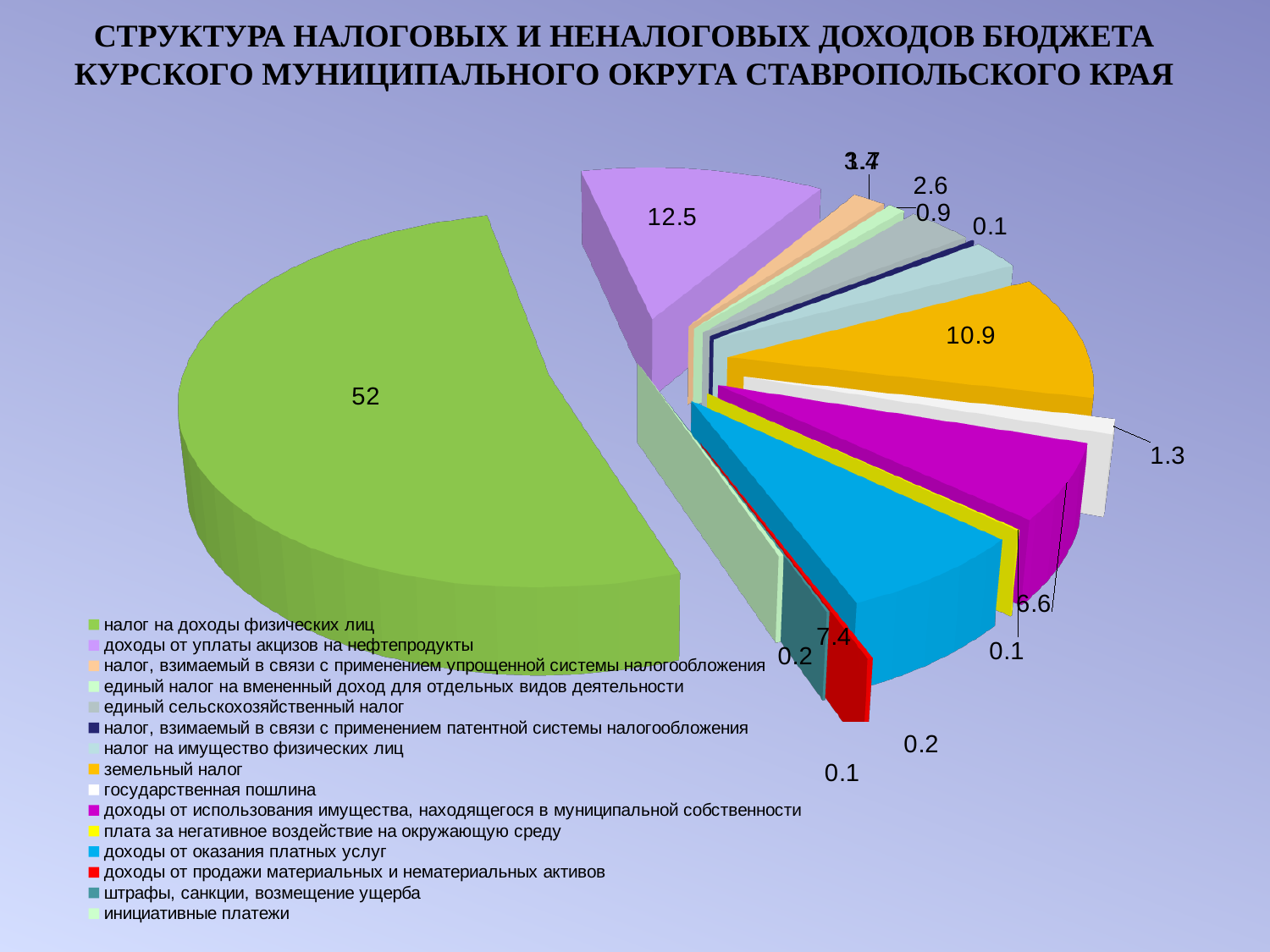
What is the value for земельный налог? 10.9 Which category has the largest slice of the pie? налог на доходы физических лиц What colour is the slice for земельный налог? orange What kind of chart is shown on the slide? pie chart What is the difference between the values for налог на доходы физических лиц and доходы от уплаты акцизов на нефтепродукты? 39.5 Which is larger: земельный налог or доходы от оказания платных услуг? земельный налог What is the value for доходы от оказания платных услуг? 7.4 What is the value for доходы от уплаты акцизов на нефтепродукты? 12.5 How many categories does the legend list? 15 What is the value for налог на доходы физических лиц? 52 What is the value for доходы от использования имущества, находящегося в муниципальной собственности? 6.6 What is the value for государственная пошлина? 1.3